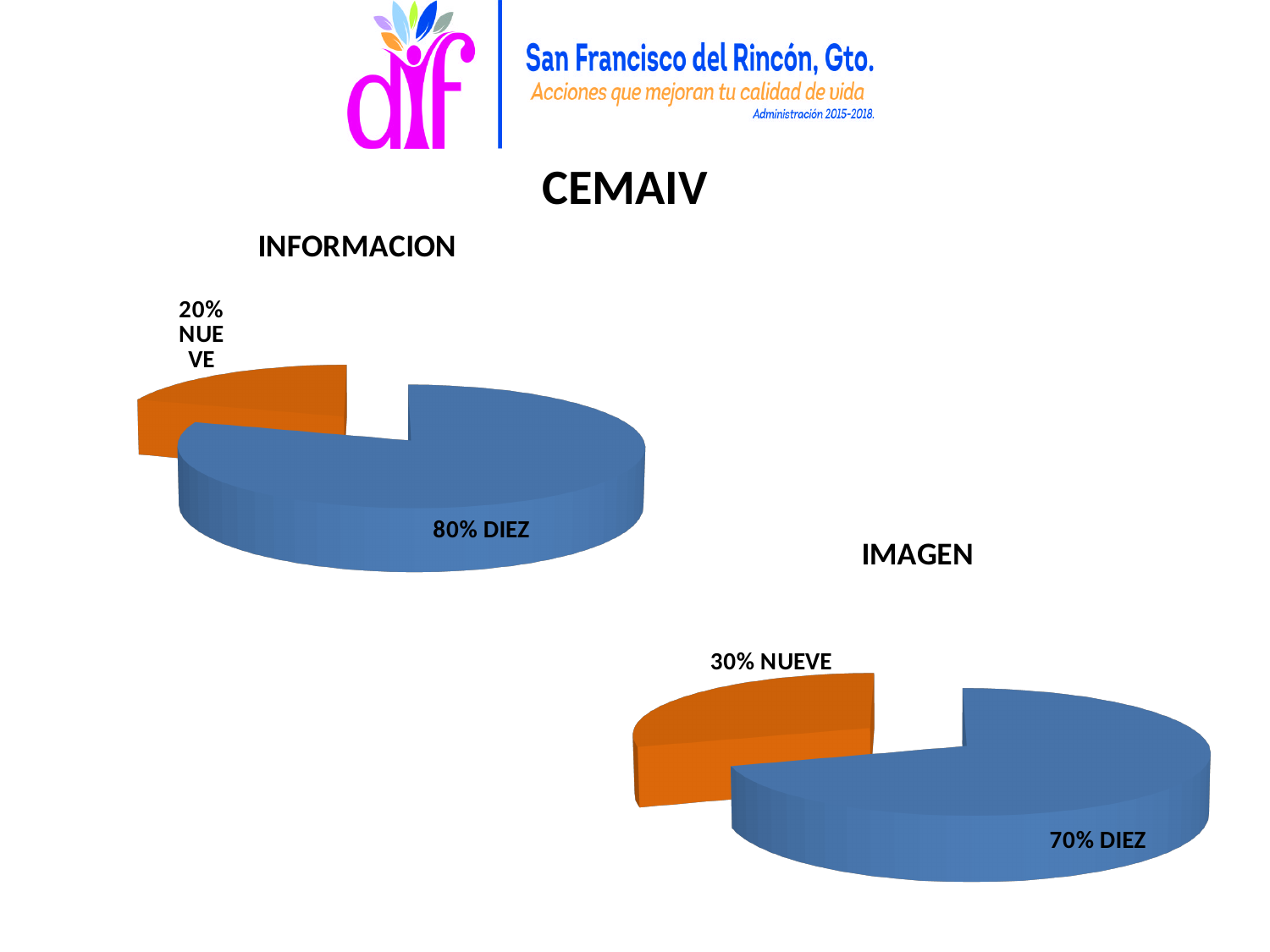
What colour is the DIEZ slice in the IMAGEN chart? Blue In the INFORMACION chart, what is the difference between the DIEZ and NUEVE shares? 60% How many slices does the INFORMACION chart have? 2 What kind of chart is the IMAGEN chart? Pie chart In the IMAGEN chart, what share of the pie is labelled DIEZ? 70% In the IMAGEN chart, what share of the pie is labelled NUEVE? 30% In the INFORMACION chart, what share of the pie is labelled NUEVE? 20% In the INFORMACION chart, which slice is the largest? DIEZ In the IMAGEN chart, which slice is the smallest? NUEVE In the IMAGEN chart, which slice is larger, DIEZ or NUEVE? DIEZ In the IMAGEN chart, what is the difference between the DIEZ and NUEVE shares? 40%